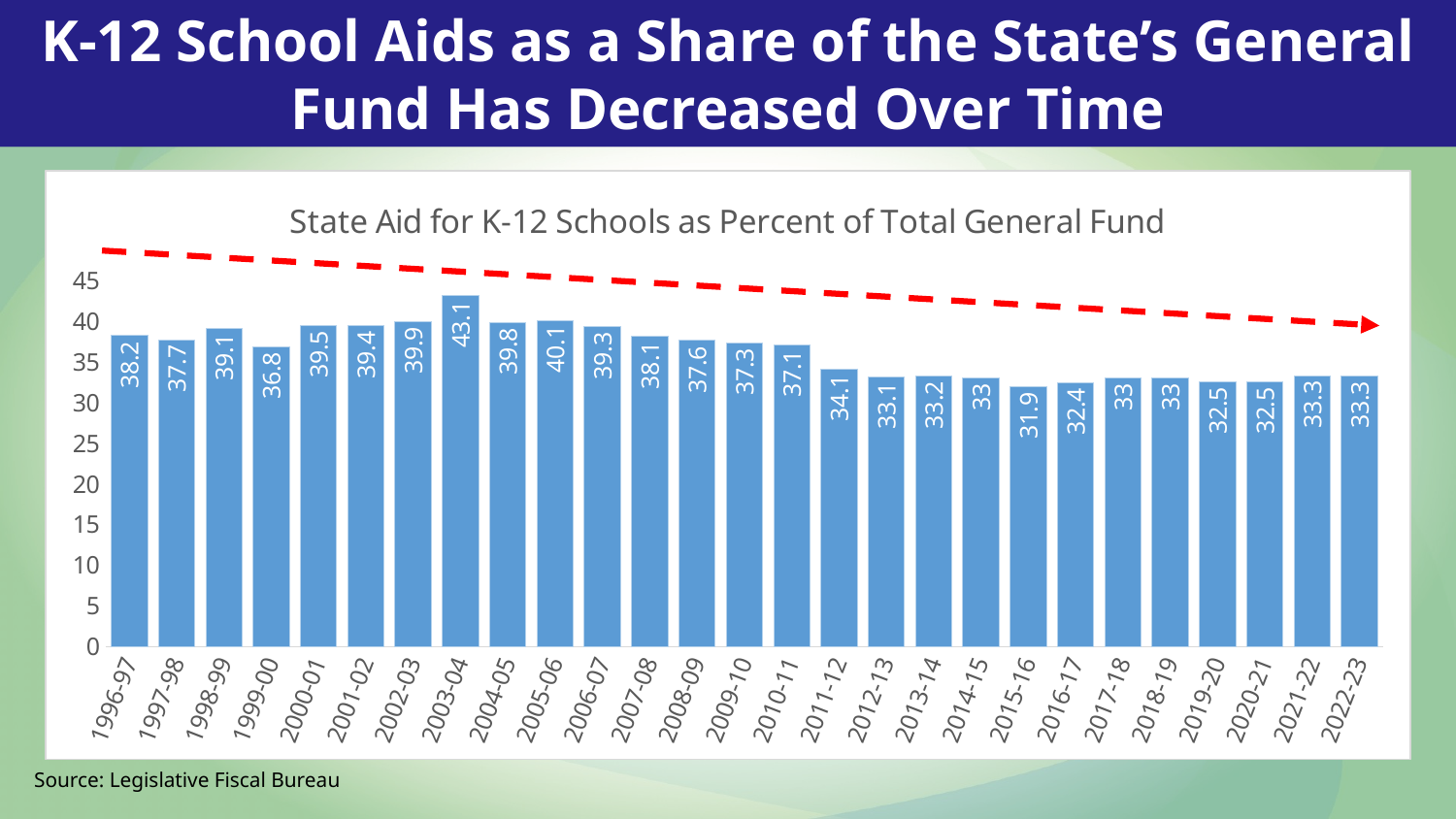
Which is larger, the value for 1999-00 or the value for 2000-01? 2000-01 Which year has the highest value? 2003-04 What is the value for 2003-04? 43.1 What is the title of the chart? State Aid for K-12 Schools as Percent of Total General Fund What is the difference between the values for 2003-04 and 2015-16? 11.2 What is the value for 2022-23? 33.3 How many years are shown on the x axis? 27 What is the value for 1996-97? 38.2 What type of chart is shown on the slide? Bar chart Do the values generally rise or fall from 1996-97 to 2022-23? Fall What is the value for 2011-12? 34.1 Which year has the lowest value? 2015-16